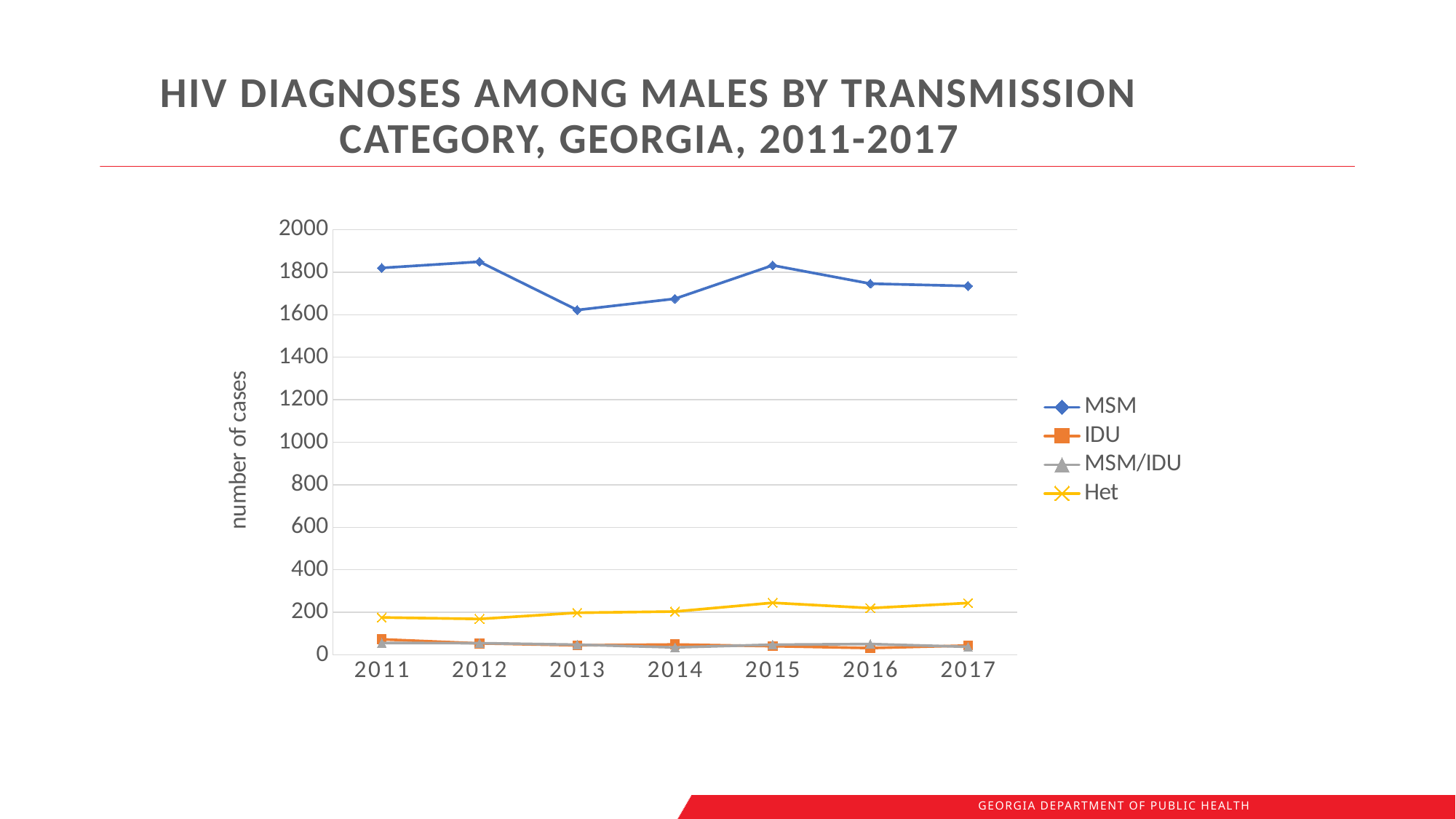
Is the MSM value for 2012 greater or less than 1800? greater How many series does the legend list? 4 Is the MSM value for 2013 greater or less than 1800? less Is the Het value for 2015 greater or less than 400? less In which year does the MSM series reach its lowest value? 2013 In which year does the MSM series reach its highest value? 2012 Which transmission category has the highest number of cases across all years? MSM Which is larger, the Het value in 2017 or the IDU value in 2017? Het What is the label on the y axis? number of cases What kind of chart is shown on the slide? line chart How many years are plotted along the x axis? 7 Does the Het series generally rise or fall from 2011 to 2017? rise